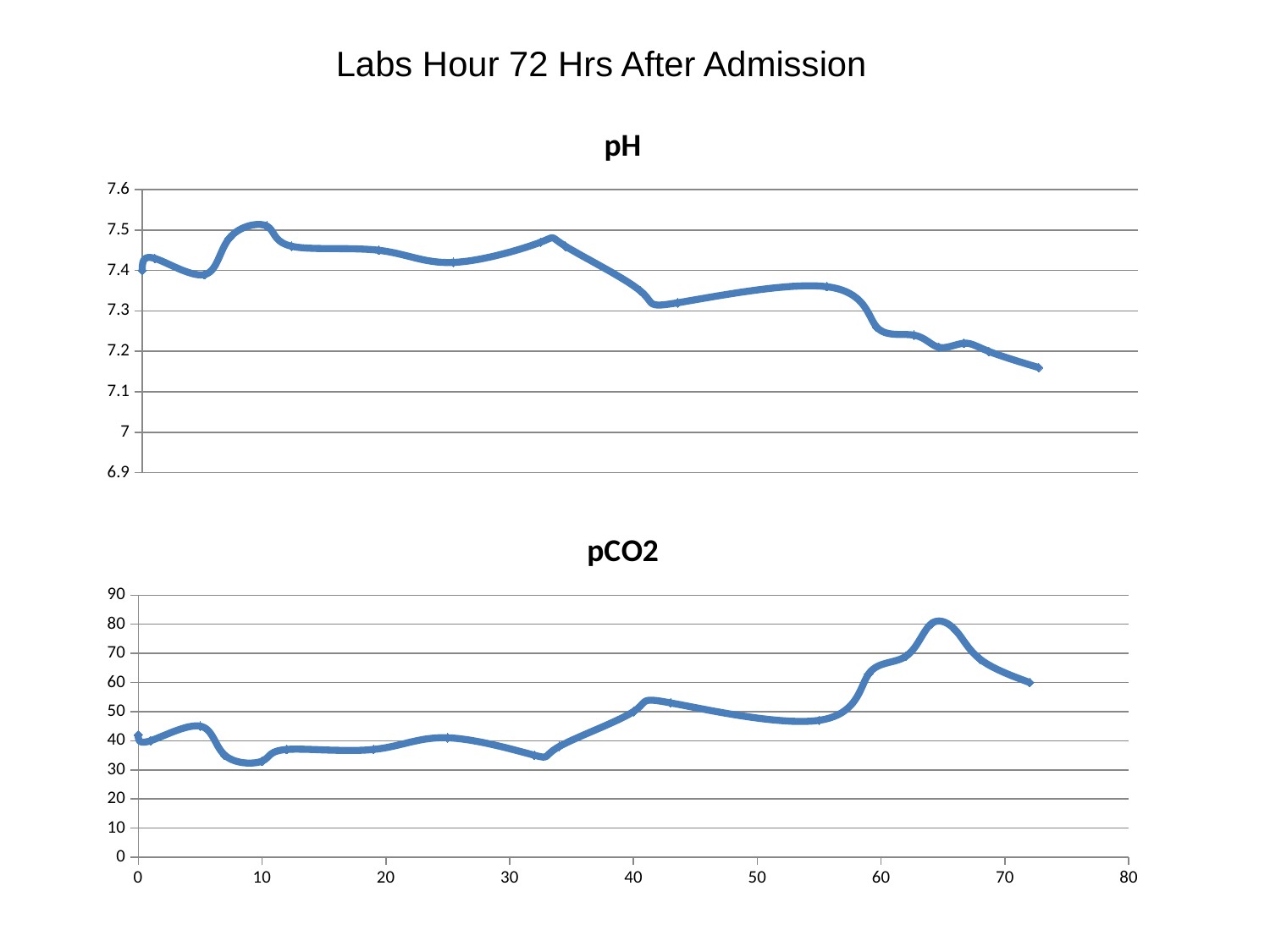
In the pH chart, does the value overall rise or fall from hour 0 to hour 72? fall In the pCO2 chart, in which x-axis interval does the line reach its highest point? between 60 and 70 What is the title of the slide? Labs Hour 72 Hrs After Admission In the pH chart, is the final value at the right end of the line greater or less than 7.2? less In the pCO2 chart, does the value overall rise or fall from hour 0 to hour 72? rise What is the highest value shown on the y axis of the pCO2 chart? 90 In the pH chart, is the value at hour 0 larger or smaller than the value at hour 72? larger In the pCO2 chart, is the value at around hour 9 greater or less than 40? less In the pCO2 chart, is the peak value between hours 60 and 70 greater or less than 70? greater What kind of chart is the pH chart? line chart What kind of chart is the pCO2 chart? line chart